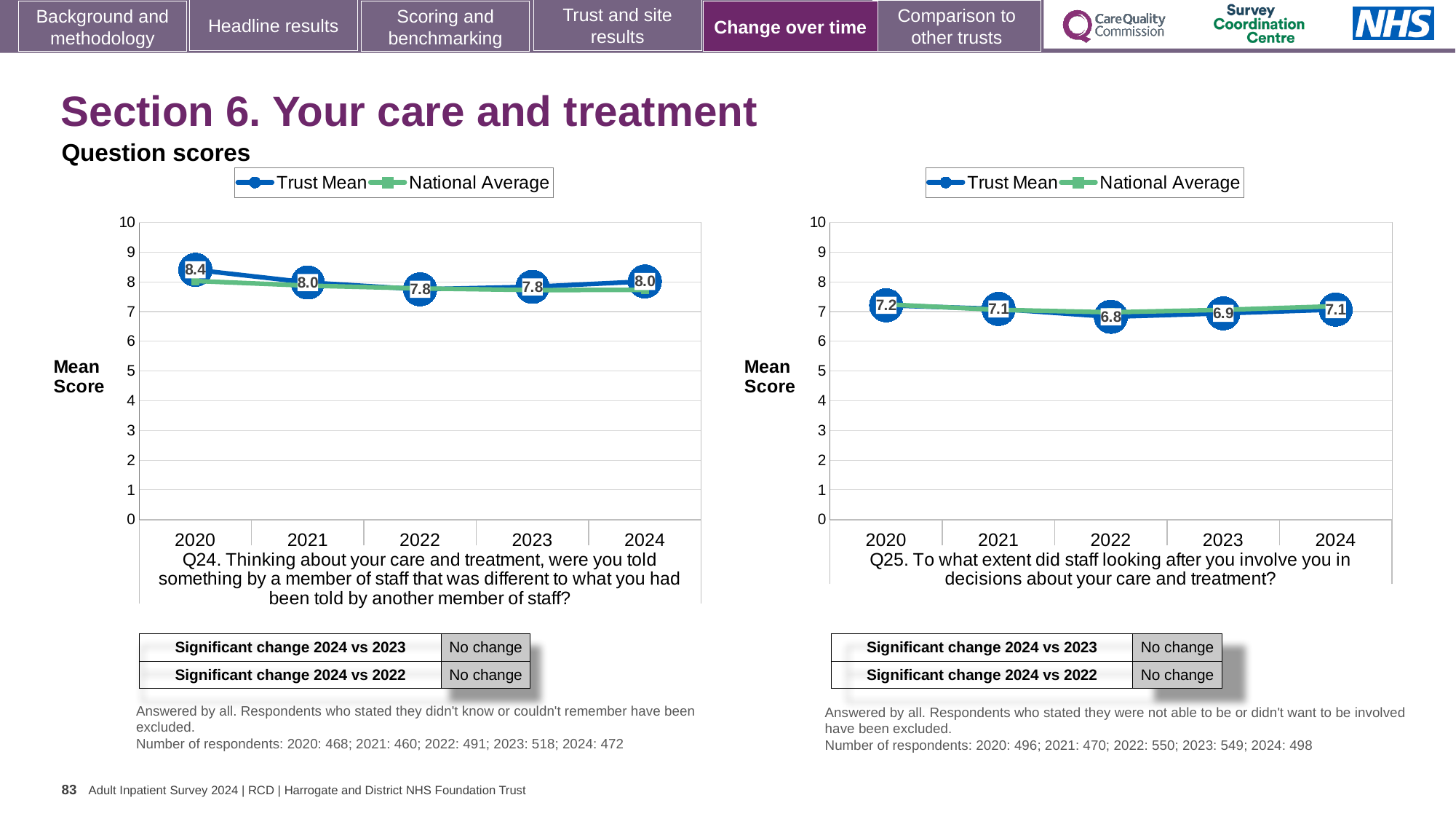
In the Q25 chart (right), which year has the highest Trust Mean score? 2020 In the Q25 chart (right), what is the difference between the Trust Mean scores for 2020 and 2022? 0.4 How many years are shown on the x axis of the Q24 chart (left)? 5 In the Q25 chart (right), what is the Trust Mean score for 2022? 6.8 In the Q24 chart (left), what is the Trust Mean score for 2020? 8.4 What type of chart is used for the Q24 chart (left)? Line chart How many series does the legend of the Q25 chart (right) list? 2 In the Q25 chart (right), which year has the lowest Trust Mean score? 2022 In the Q24 chart (left), what is the difference between the Trust Mean scores for 2020 and 2022? 0.6 In the Q24 chart (left), is the Trust Mean score higher in 2020 or in 2021? 2020 In the Q25 chart (right), is the Trust Mean score for 2023 greater or less than 8? less In the Q24 chart (left), what is the Trust Mean score for 2024? 8.0